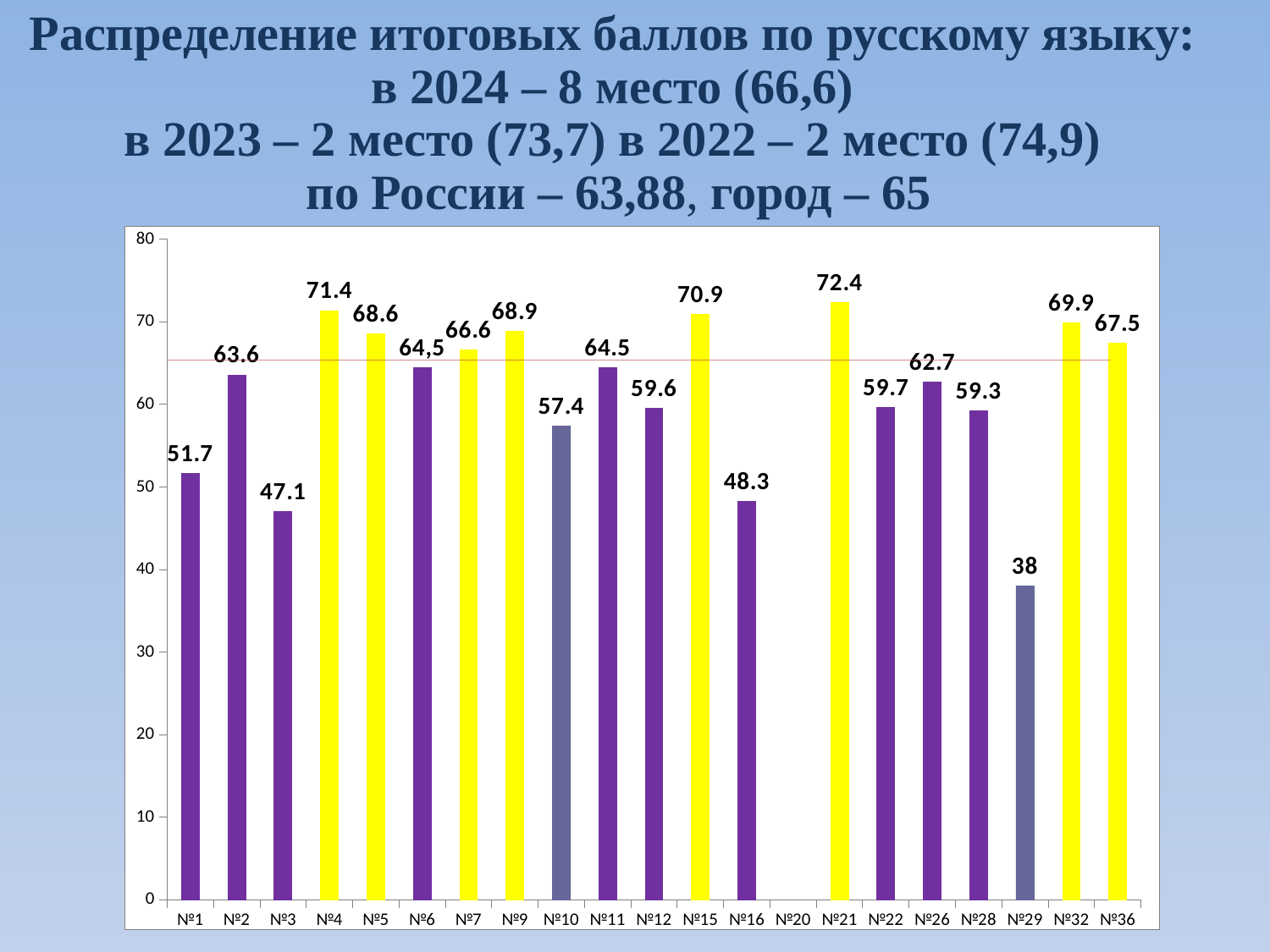
Which is larger, the value for №2 or the value for №3? №2 What is the value shown for №6? 64,5 What is the difference between the values for №21 and №29? 34.4 Is the value for №10 greater or less than 50? greater How many categories are labelled on the x axis? 21 What is the value shown for №21? 72.4 Which category has the lowest value? №29 What is the value shown for №29? 38 What kind of chart is shown on the slide? bar chart What is the value shown for №16? 48.3 Which category has the highest value? №21 What is the difference between the values for №4 and №1? 19.7